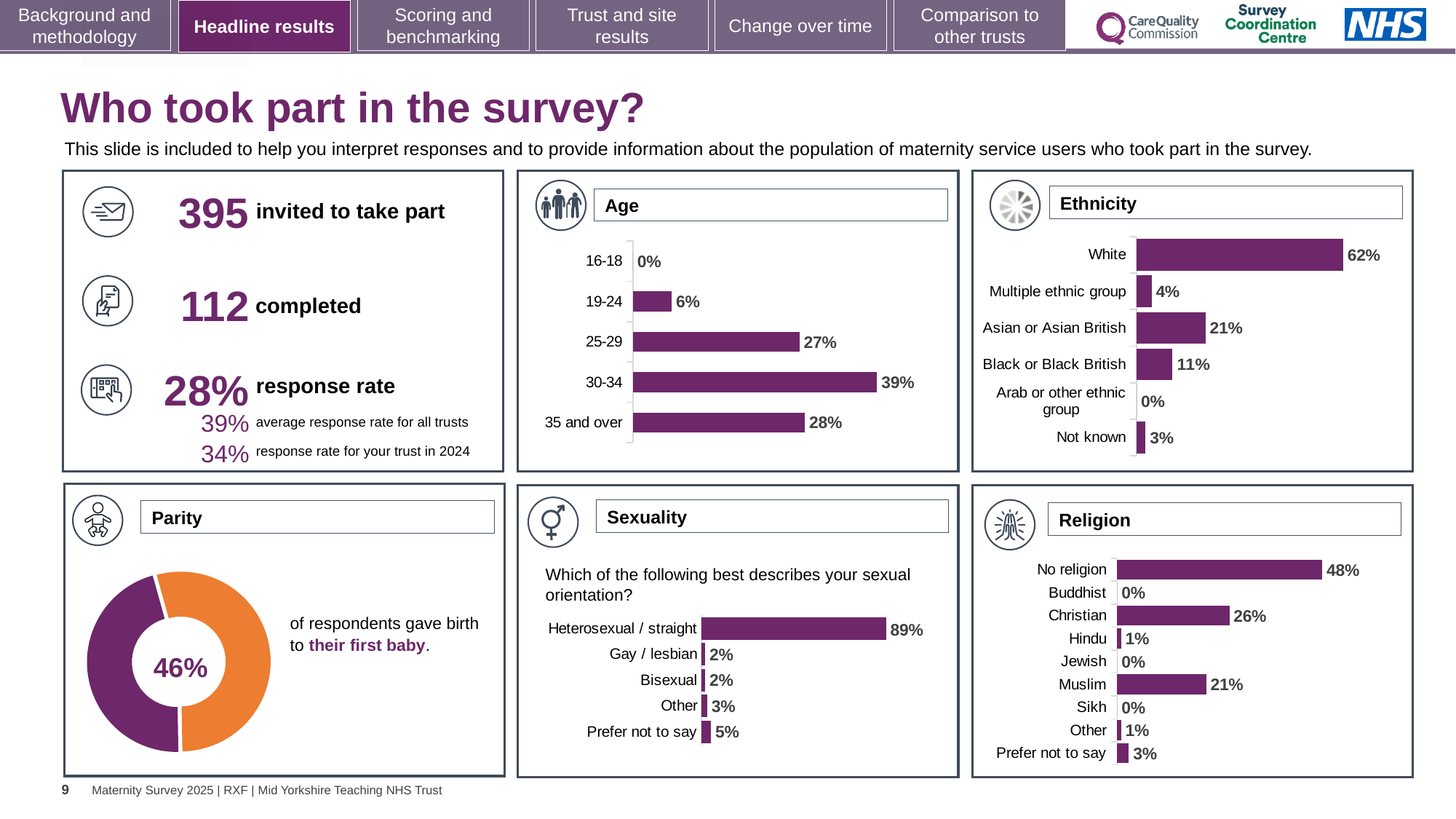
In the Religion chart, what percentage of respondents were Muslim? 21% In the Sexuality chart, what percentage of respondents answered Heterosexual / straight? 89% In the Religion chart, which is larger, the percentage for Christian or the percentage for Muslim? Christian In the Religion chart, which religion category has the highest percentage? No religion In the Ethnicity chart, what percentage of respondents were White? 62% In the Sexuality chart, how many response categories are shown? 5 In the Parity chart, what share of respondents gave birth to their first baby? 46% What kind of chart is the Parity chart? Doughnut chart In the Age chart, what percentage of respondents were aged 30-34? 39% In the Ethnicity chart, what is the difference between the percentages for Asian or Asian British and Black or Black British? 10% In the Age chart, which age group has the highest percentage? 30-34 In the Ethnicity chart, how many ethnicity categories are shown? 6